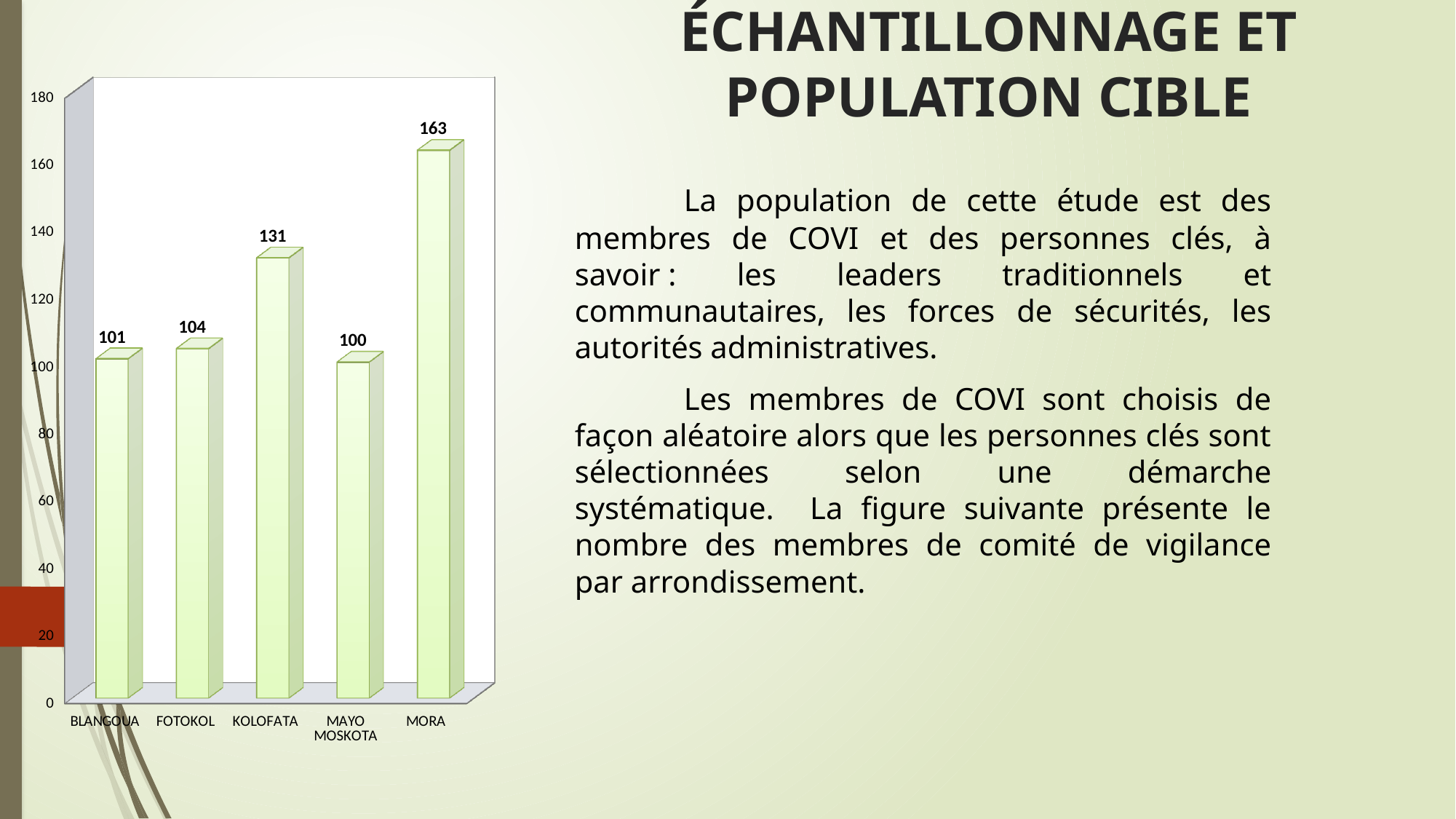
What is the value for BLANGOUA? 101 Which is larger, the value for KOLOFATA or the value for FOTOKOL? KOLOFATA What is the difference between the values for FOTOKOL and MAYO MOSKOTA? 4 Is the value for MORA greater or less than 140? greater How many categories are shown on the x axis? 5 What is the value for MORA? 163 Which category has the highest value? MORA What is the difference between the values for MORA and KOLOFATA? 32 What is the highest tick value shown on the vertical axis? 180 Which category has the lowest value? MAYO MOSKOTA What kind of chart is shown on the slide? bar chart What is the value for KOLOFATA? 131